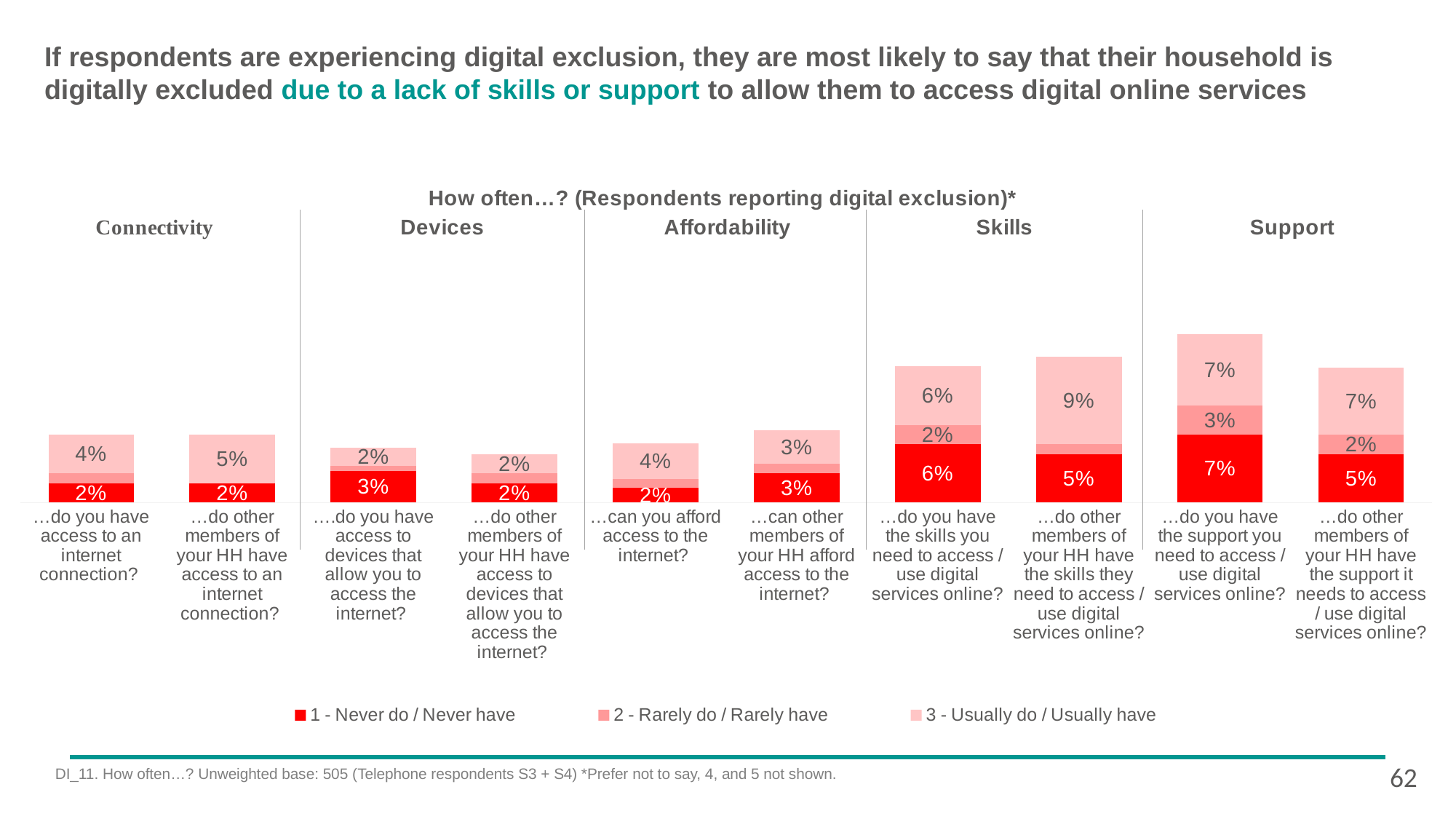
How many question categories (bars) are plotted along the x axis? 10 What is the total of the stacked bar for '…do you have the skills you need to access / use digital services online?' 14% Which question has the highest '3 - Usually do / Usually have' value? …do other members of your HH have the skills they need to access / use digital services online? What is the '2 - Rarely do / Rarely have' value for '…do you have the skills you need to access / use digital services online?' 2% What is the '3 - Usually do / Usually have' value for '…do other members of your HH have the skills they need to access / use digital services online?' 9% What is the total of the stacked bar for '…do you have the support you need to access / use digital services online?' 17% How many series does the legend list? 3 Which has the larger '1 - Never do / Never have' value: '…do you have the skills you need…' or '…do other members of your HH have the skills they need…'? …do you have the skills you need to access / use digital services online? Which question has the highest '1 - Never do / Never have' value? …do you have the support you need to access / use digital services online? What is the difference between the '3 - Usually do / Usually have' values for '…do other members of your HH have the skills they need…' (9%) and '…do you have the skills you need…' (6%)? 3 percentage points What kind of chart is shown on the slide? Stacked bar chart What is the '1 - Never do / Never have' value for '…do you have the support you need to access / use digital services online?' 7%